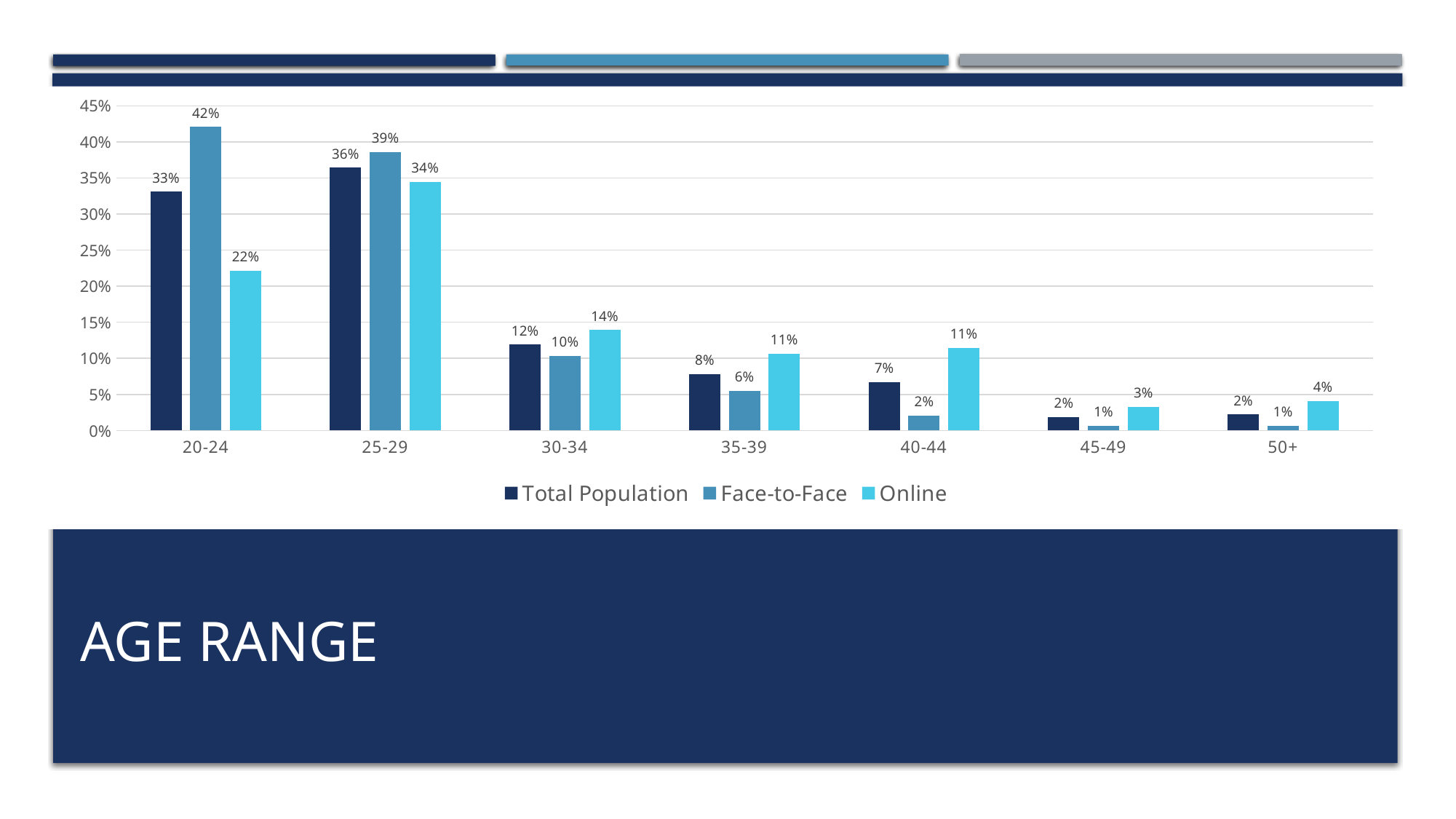
Which is larger for the 40-44 age range, Face-to-Face or Online? Online How many series does the legend list? 3 What is the Face-to-Face value for the 20-24 age range? 42% Which age range has the lowest Face-to-Face value? 45-49 and 50+ (both 1%) Do the Total Population values rise or fall from the 25-29 age range to the 50+ age range? Fall What is the difference between the Face-to-Face and Online values for the 20-24 age range? 20% What is the title shown on the slide? AGE RANGE What is the Total Population value for the 35-39 age range? 8% What is the Online value for the 25-29 age range? 34% How many age range categories are shown on the x axis? 7 Which age range has the highest Online value? 25-29 What kind of chart is shown on the slide? Bar chart